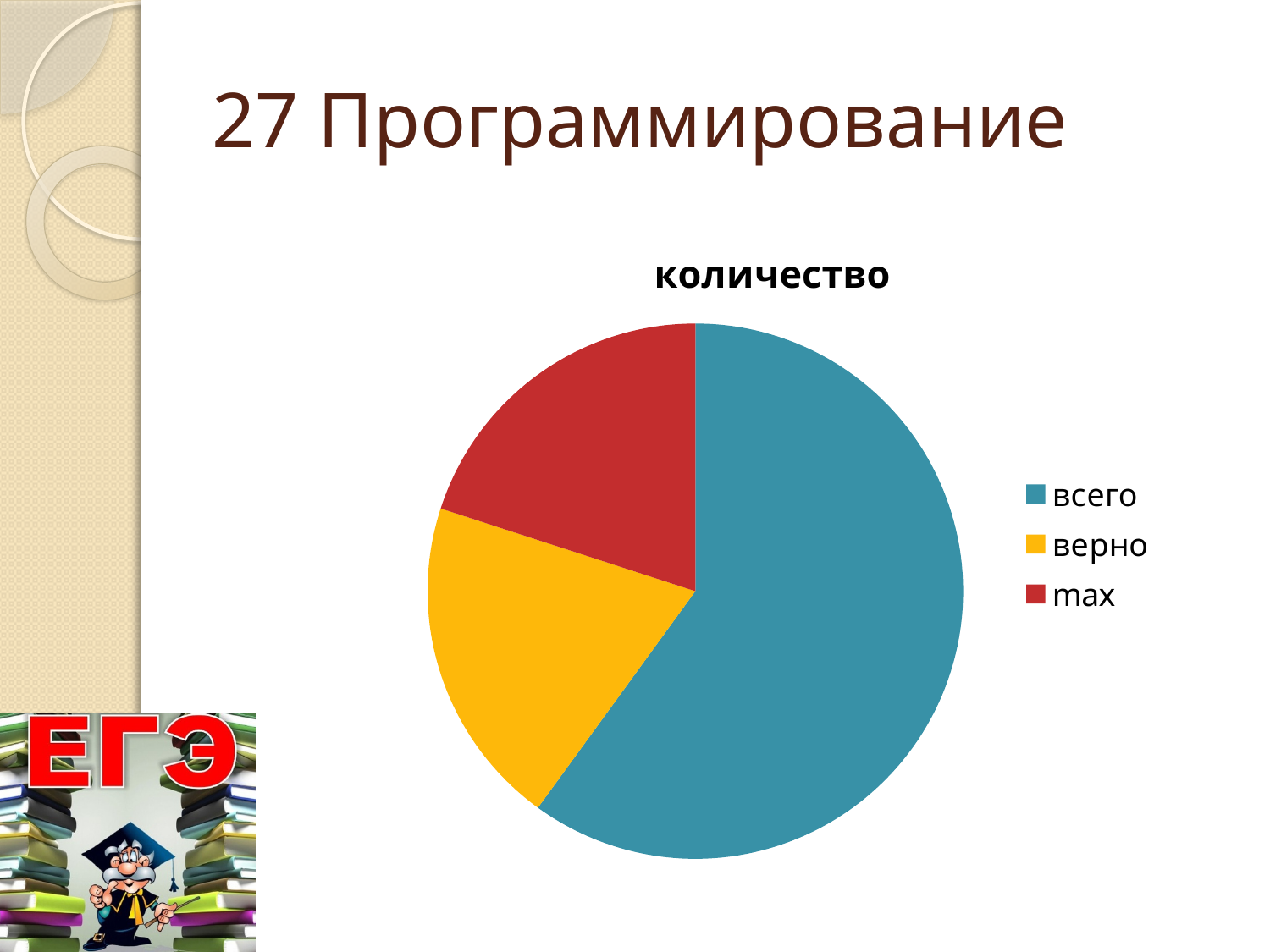
How many slices does the pie chart have? 3 Which slice is larger, всего or верно? всего What colour is the slice for всего in the pie chart? blue Does the slice for всего take up more or less than half of the pie? more Which slice is larger, всего or max? всего What kind of chart is shown on the slide? pie chart Which category has the largest slice in the pie chart? всего How many entries does the legend of the pie chart list? 3 What is the title of the pie chart? количество